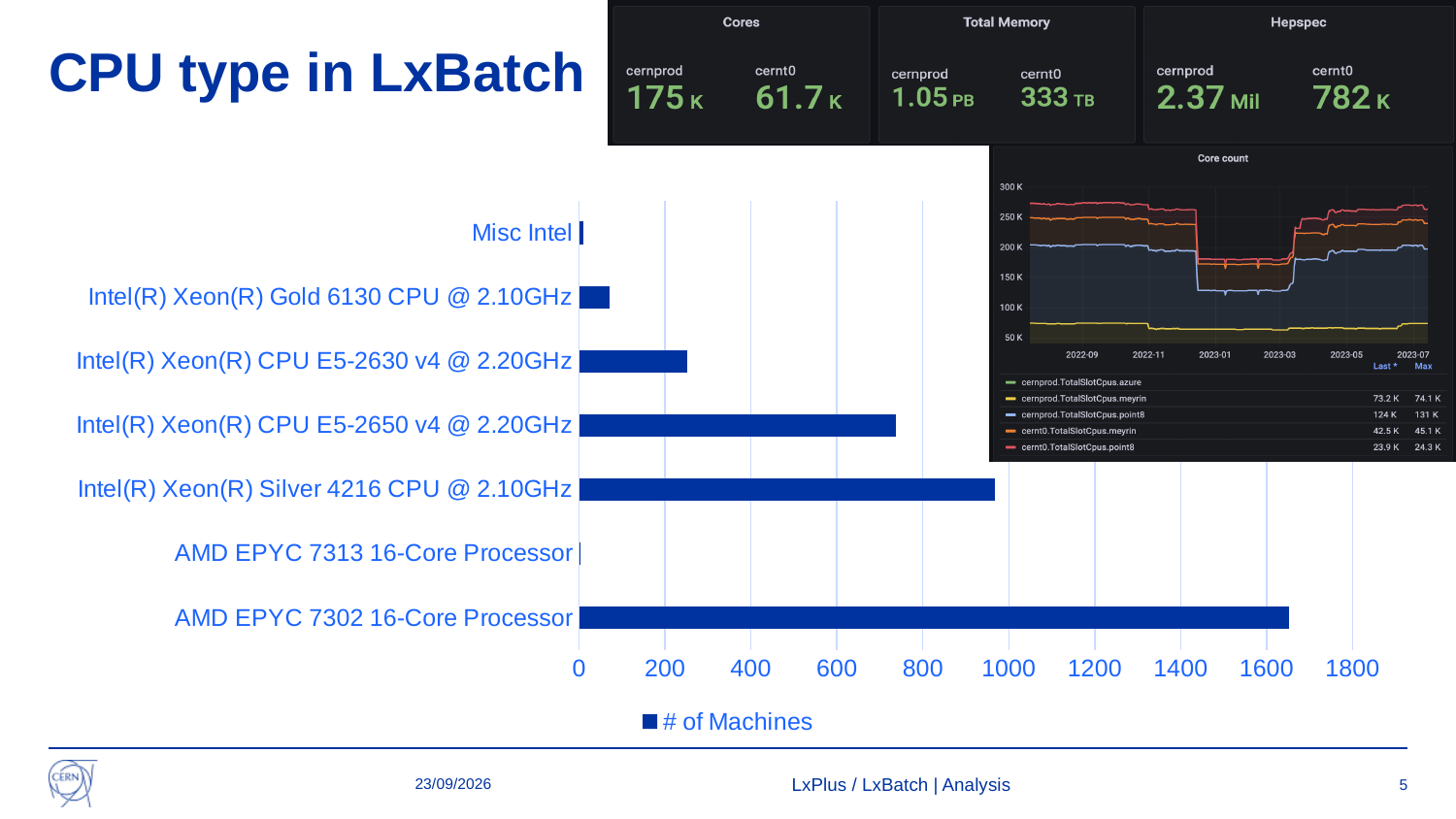
In the bar chart, is the number of machines for AMD EPYC 7302 16-Core Processor greater or less than 1600? greater What kind of chart is the main chart on the left of the slide? bar chart How many CPU type categories are shown in the bar chart? 7 How many series does the legend of the bar chart list? 1 In the bar chart, is the number of machines for Intel(R) Xeon(R) Gold 6130 CPU @ 2.10GHz greater or less than 200? less In the Cores panel at the top right of the slide, what is the value shown for cernprod? 175 K In the bar chart, is the number of machines for Intel(R) Xeon(R) CPU E5-2650 v4 @ 2.20GHz greater or less than 600? greater Which CPU type has the highest number of machines in the bar chart? AMD EPYC 7302 16-Core Processor What is the legend label of the series in the bar chart? # of Machines In the bar chart, which has more machines: Intel(R) Xeon(R) CPU E5-2630 v4 @ 2.20GHz or Intel(R) Xeon(R) Gold 6130 CPU @ 2.10GHz? Intel(R) Xeon(R) CPU E5-2630 v4 @ 2.20GHz In the bar chart, which has more machines: Intel(R) Xeon(R) Silver 4216 CPU @ 2.10GHz or Intel(R) Xeon(R) CPU E5-2650 v4 @ 2.20GHz? Intel(R) Xeon(R) Silver 4216 CPU @ 2.10GHz